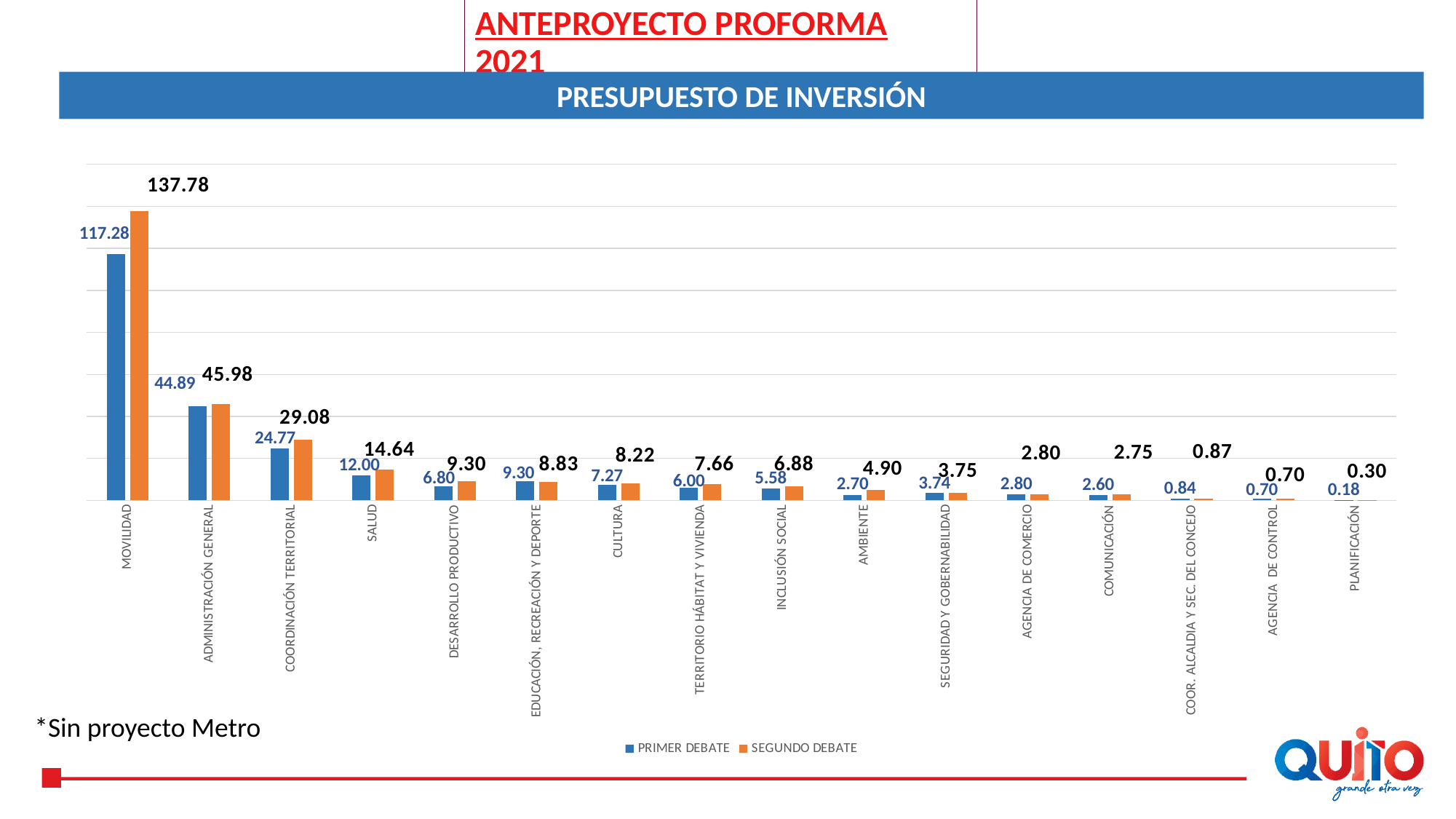
What kind of chart is shown on the slide? Bar chart What is the difference between the SEGUNDO DEBATE and PRIMER DEBATE values for MOVILIDAD? 20.50 How many series does the legend list? 2 How many categories are shown on the x axis of the chart? 16 What is the SEGUNDO DEBATE value for MOVILIDAD? 137.78 What is the difference between the SEGUNDO DEBATE and PRIMER DEBATE values for AMBIENTE? 2.20 What is the PRIMER DEBATE value for PLANIFICACIÓN? 0.18 Which category has the lowest PRIMER DEBATE value? PLANIFICACIÓN Which category has the highest SEGUNDO DEBATE value? MOVILIDAD For EDUCACIÓN, RECREACIÓN Y DEPORTE, which is larger: the PRIMER DEBATE value or the SEGUNDO DEBATE value? PRIMER DEBATE What is the PRIMER DEBATE value for COORDINACIÓN TERRITORIAL? 24.77 What is the SEGUNDO DEBATE value for SALUD? 14.64